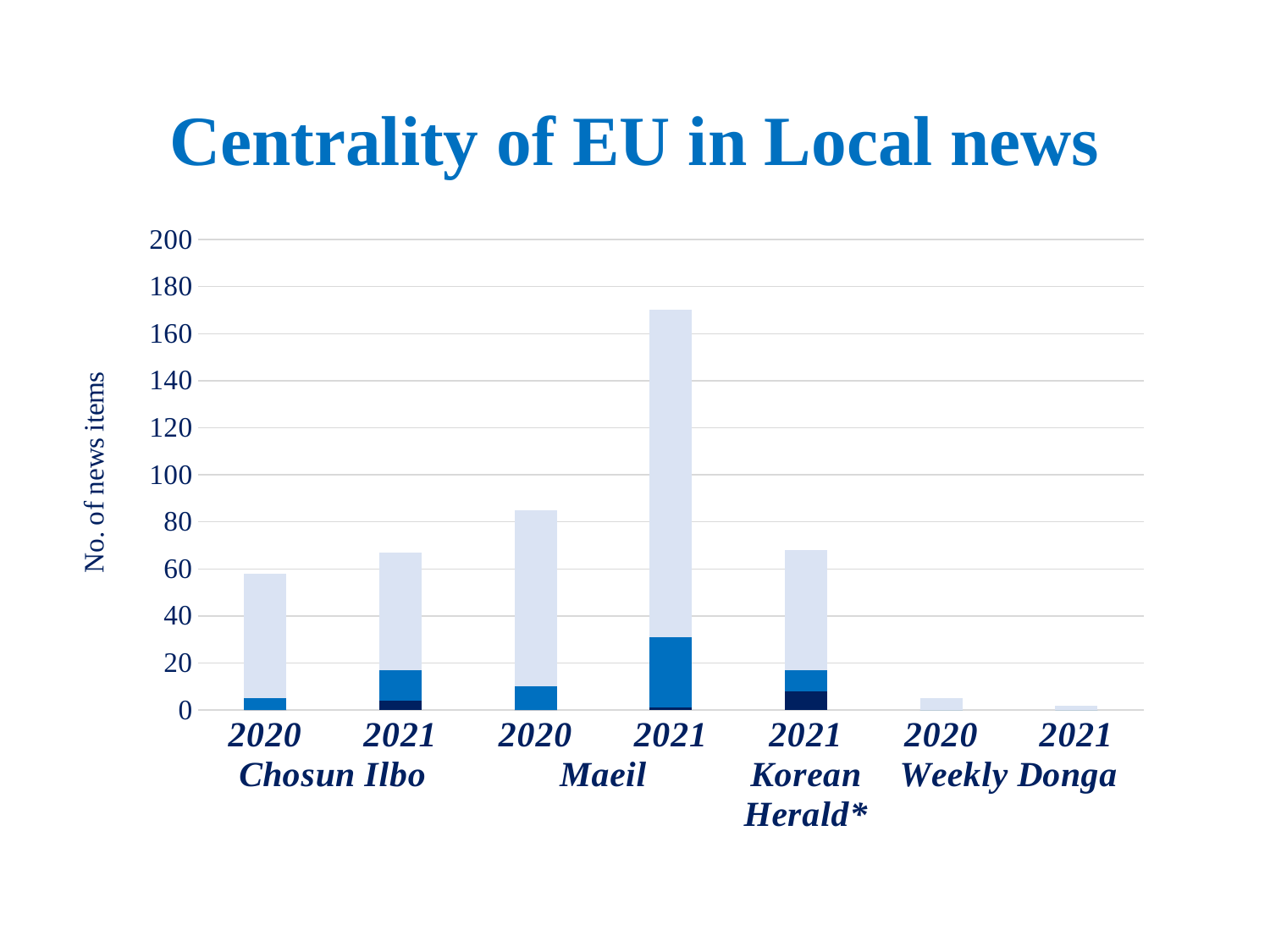
What is the title of the chart? Centrality of EU in Local news Which has a larger total, Maeil 2020 or Chosun Ilbo 2021? Maeil 2020 Is the total for Weekly Donga 2020 greater or less than 20? less What is the label on the vertical axis? No. of news items Is the total for Maeil 2020 greater or less than 60? greater Is the total for Chosun Ilbo 2020 greater or less than 40? greater Which bar has the lowest total number of news items? Weekly Donga 2021 How many bars are plotted in the chart? 7 What kind of chart is shown on the slide? Stacked bar chart Which bar has the highest total number of news items? Maeil 2021 Which has a larger total, Weekly Donga 2020 or Weekly Donga 2021? Weekly Donga 2020